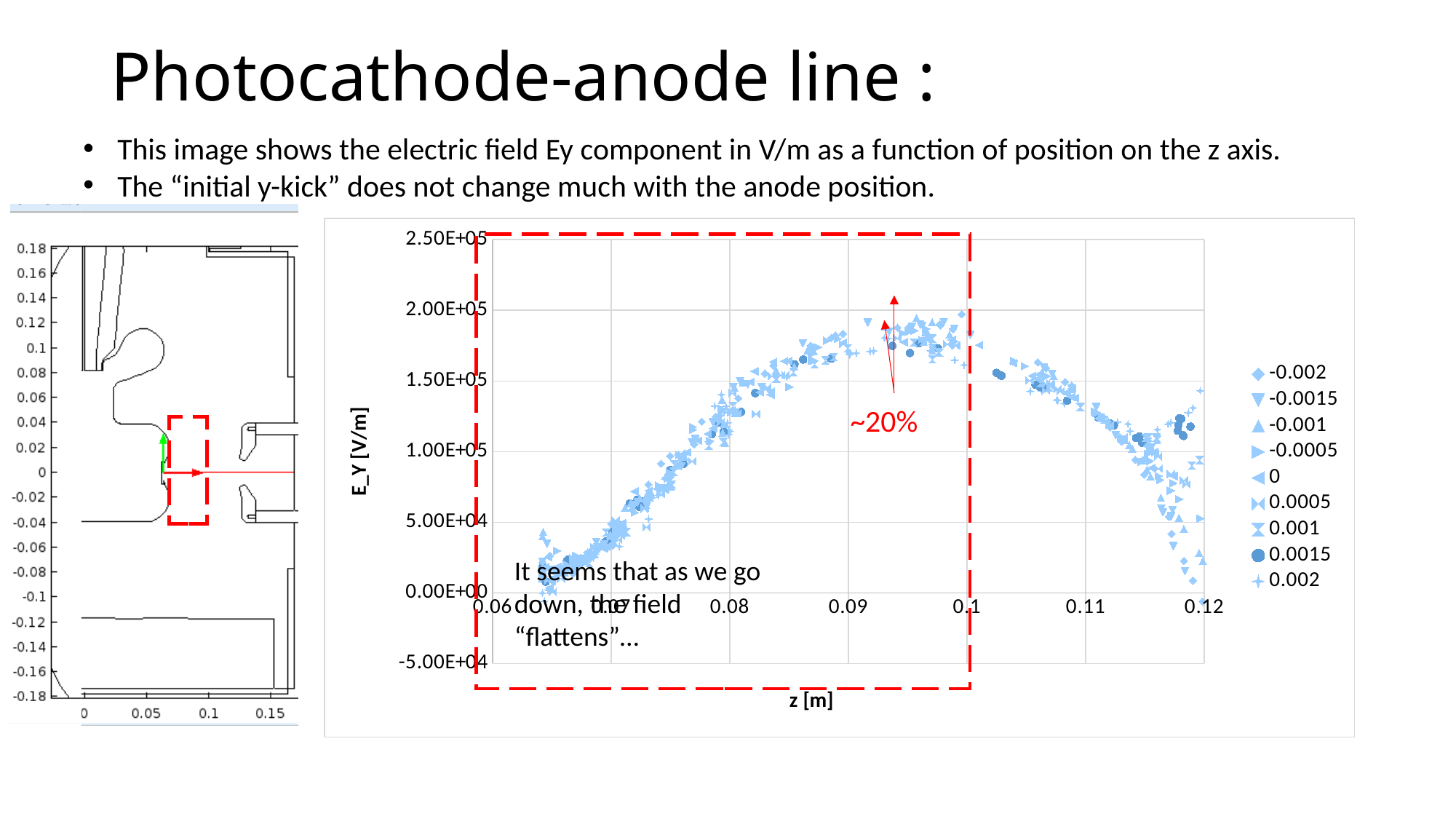
In the scatter chart, are the E_Y values at z = 0.11 greater or less than 1.00E+05? greater In the scatter chart, which is larger: the E_Y value at z = 0.09 or at z = 0.07? z = 0.09 What kind of chart is shown on the right of the slide? scatter chart What is the label of the x axis of the scatter chart? z [m] In the scatter chart, are the E_Y values at z = 0.1 greater or less than 2.00E+05? less How many series does the legend of the scatter chart list? 9 What is the label of the y axis of the scatter chart? E_Y [V/m] In the scatter chart, do the E_Y values rise or fall as z increases from 0.1 to 0.12? fall What is the highest tick value shown on the y axis of the scatter chart? 2.50E+05 In the scatter chart, do the E_Y values rise or fall as z increases from 0.06 to 0.09? rise